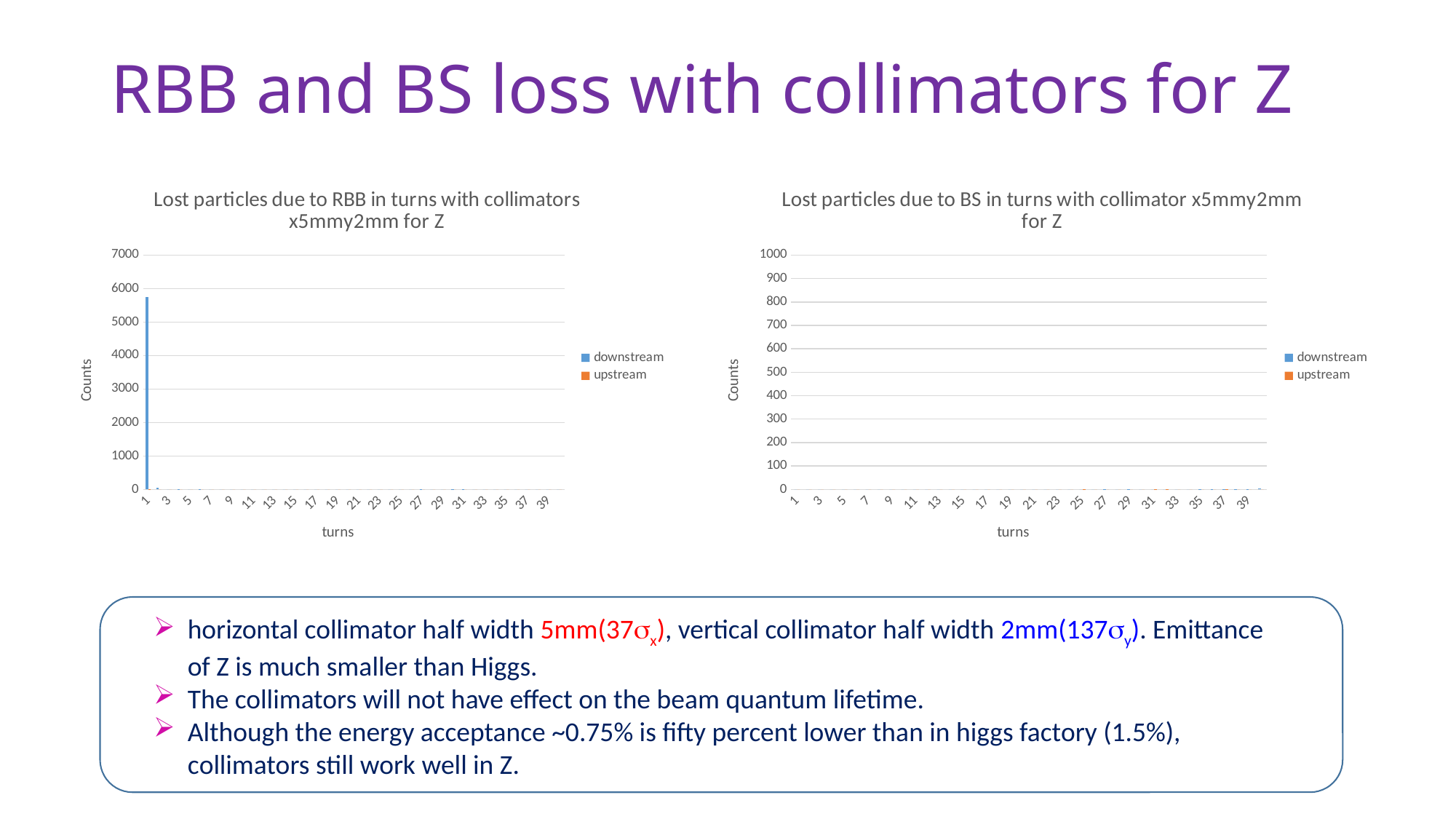
In the left chart (RBB), is the downstream value at turn 1 greater or less than 5000? greater What kind of chart is the right chart, 'Lost particles due to BS in turns with collimator x5mmy2mm for Z'? bar chart What are the two series named in the legend of the right chart (BS)? downstream, upstream In the left chart (RBB), do the downstream counts rise or fall from turn 1 to turn 39? fall In the right chart (BS), is the downstream value at turn 1 greater or less than 100? less In the left chart (RBB), which is larger, the downstream value at turn 1 or at turn 21? turn 1 What is the highest tick value on the y axis of the right chart (BS)? 1000 In the left chart (RBB), is the downstream value at turn 3 greater or less than 1000? less How many series does the legend of the left chart (RBB) list? 2 In the left chart (RBB), at which turn is the downstream count highest? 1 What kind of chart is the left chart, 'Lost particles due to RBB in turns with collimators x5mmy2mm for Z'? bar chart